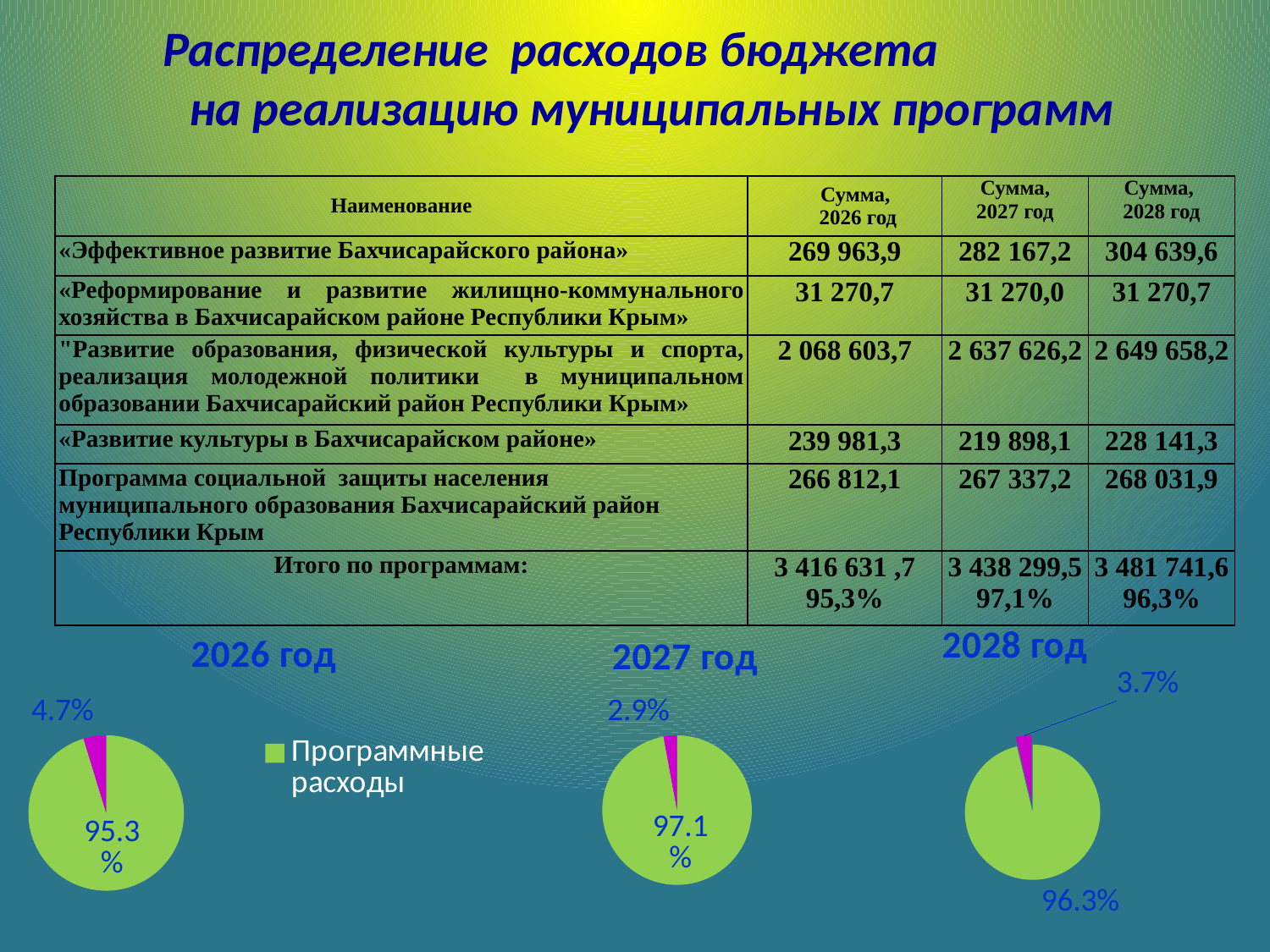
In the 2026 год pie chart, what share is shown for the small magenta slice? 4.7% In the 2027 год pie chart, what share is shown for the large green slice? 97.1% In the 2028 год pie chart, what share is shown for the large green slice? 96.3% In the 2027 год pie chart, what share is shown for the small magenta slice? 2.9% Which of the three pie charts (2026 год, 2027 год, 2028 год) shows the largest magenta slice? 2026 год How many slices does the 2027 год pie chart have? 2 In the 2026 год pie chart, what share is shown for the large green slice? 95.3% In the 2028 год pie chart, what share is shown for the small magenta slice? 3.7% What legend entry is shown next to the pie charts? Программные расходы What kind of chart is used for the 2026 год, 2027 год and 2028 год charts? pie chart Which of the three pie charts (2026 год, 2027 год, 2028 год) shows the largest green slice? 2027 год What is the difference between the green slice shares in the 2027 год and 2026 год pie charts? 1.8%